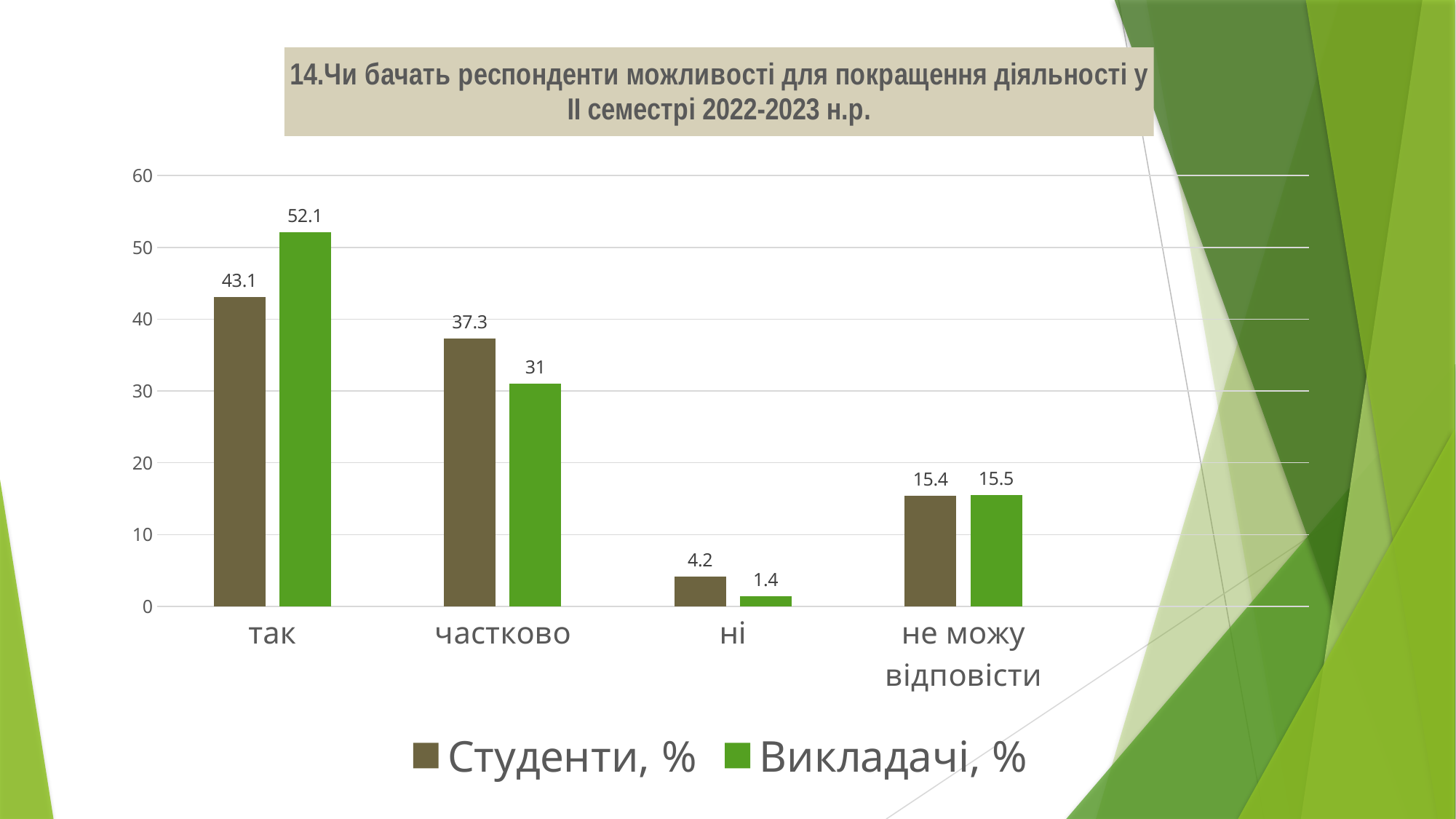
Which category has the highest value for Викладачі, %? так Which is larger in the category ні: Студенти, % or Викладачі, %? Студенти, % How many series does the legend list? 2 What is the value for Викладачі, % in the category ні? 1.4 What colour are the bars for Викладачі, %? green Which category has the lowest value for Студенти, %? ні What kind of chart is shown on the slide? bar chart What is the value for Студенти, % in the category так? 43.1 What is the difference between Студенти, % and Викладачі, % in the category частково? 6.3 What is the difference between Викладачі, % and Студенти, % in the category так? 9 What is the value for Викладачі, % in the category частково? 31 How many categories are shown on the x axis? 4